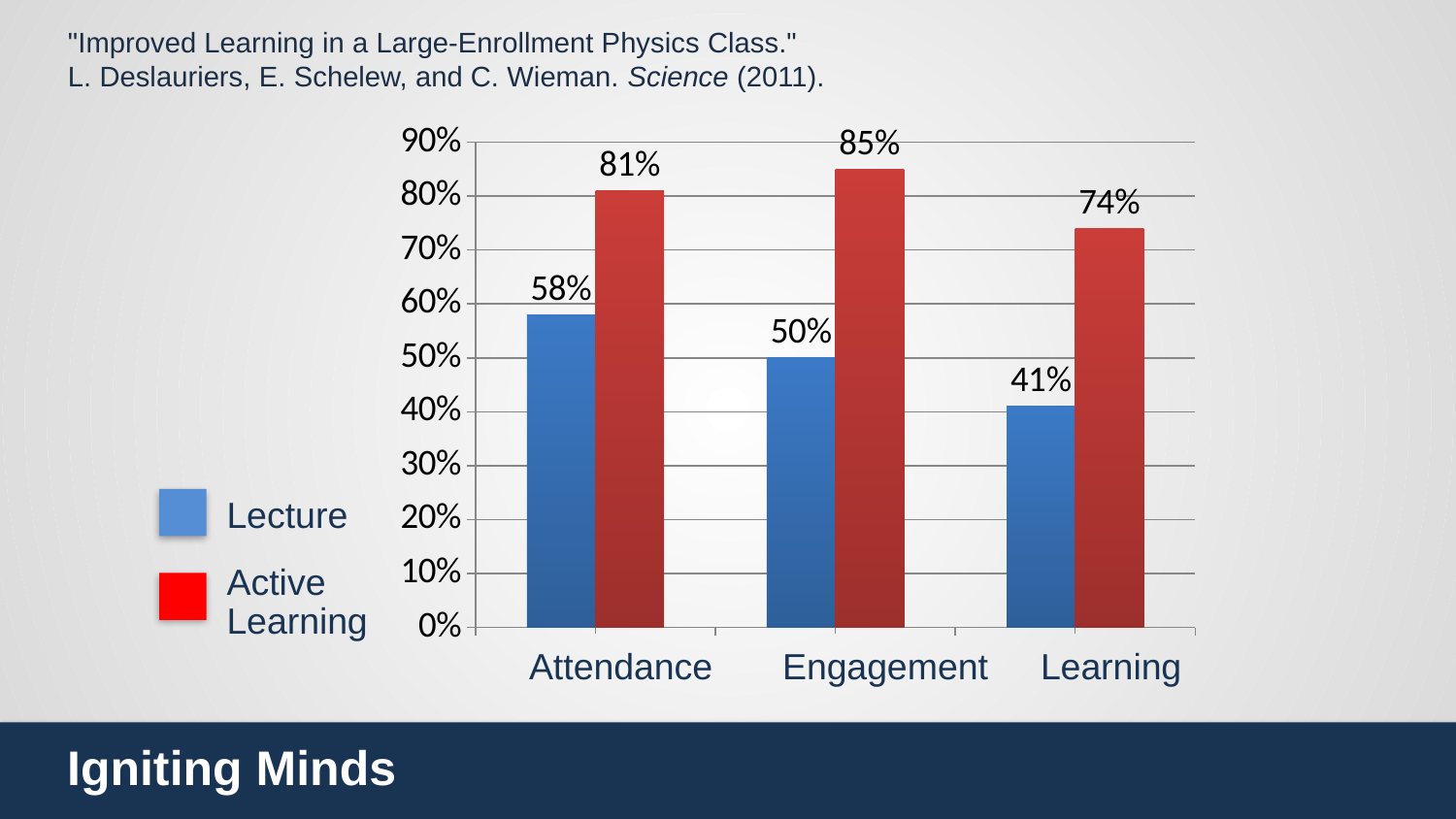
What is the Active Learning value for Engagement? 85% Which is larger for Engagement, the Lecture value or the Active Learning value? Active Learning Which category has the highest Active Learning value? Engagement What is the difference between the Active Learning and Lecture values for Attendance? 23% What kind of chart is shown on the slide? Bar chart What is the Lecture value for Learning? 41% How many series does the legend list? 2 What is the Active Learning value for Learning? 74% How many categories are shown on the x axis? 3 Which category has the lowest Lecture value? Learning What is the Lecture value for Attendance? 58% What is the difference between the Active Learning and Lecture values for Learning? 33%